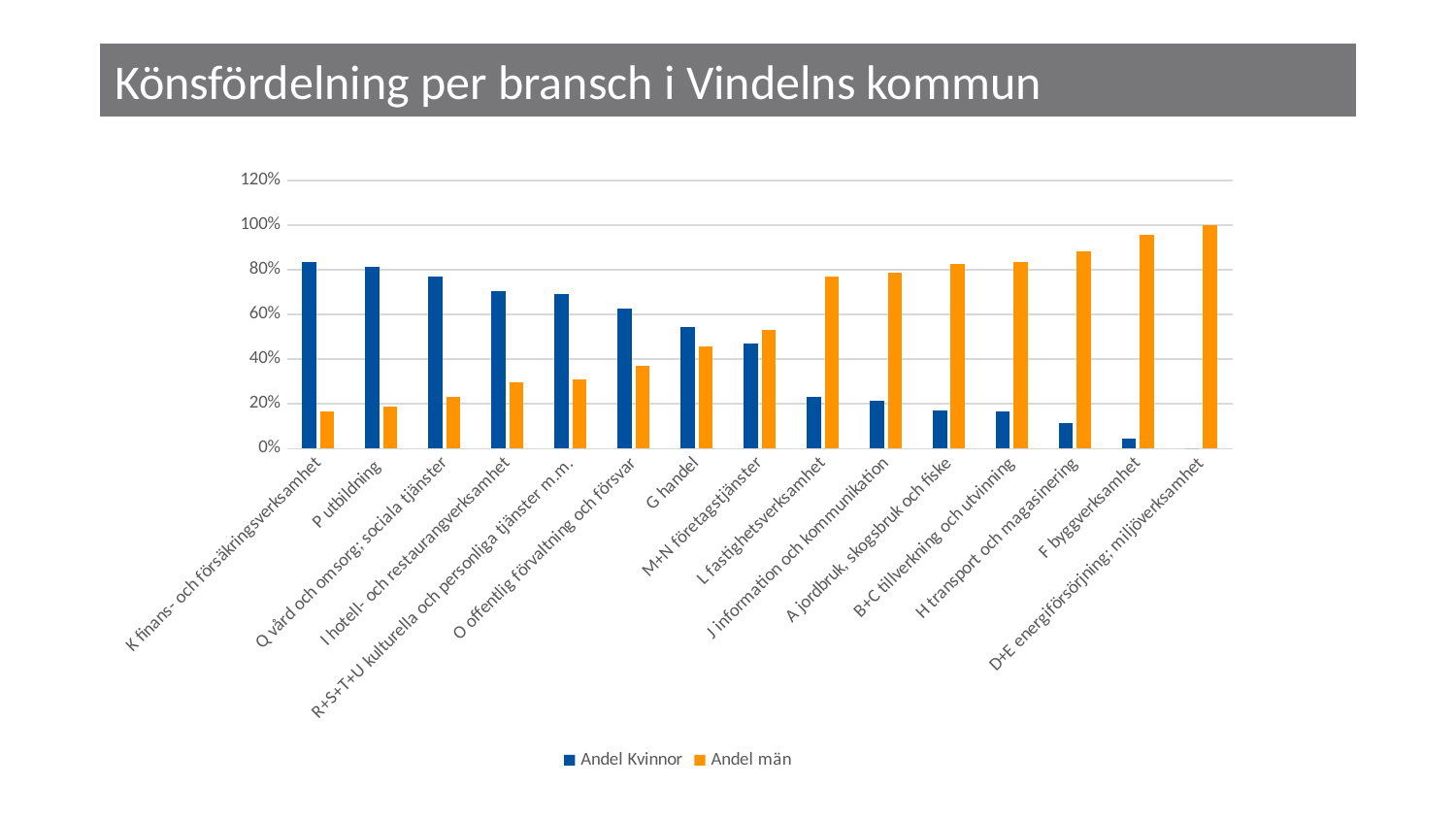
For J information och kommunikation, which is larger: Andel Kvinnor or Andel män? Andel män Is the Andel män value for F byggverksamhet greater or less than 80%? greater How many series does the legend list? 2 Which category has the lowest value for Andel Kvinnor? D+E energiförsörjning; miljöverksamhet What kind of chart is shown on the slide? bar chart Which category has the highest value for Andel män? D+E energiförsörjning; miljöverksamhet Is the Andel män value for G handel greater or less than 60%? less Do the Andel män values generally rise or fall from left to right along the x axis? rise What is the title of the chart? Könsfördelning per bransch i Vindelns kommun How many industry categories are plotted on the x axis? 15 Is the Andel Kvinnor value for P utbildning greater or less than 60%? greater For G handel, which is larger: Andel Kvinnor or Andel män? Andel Kvinnor